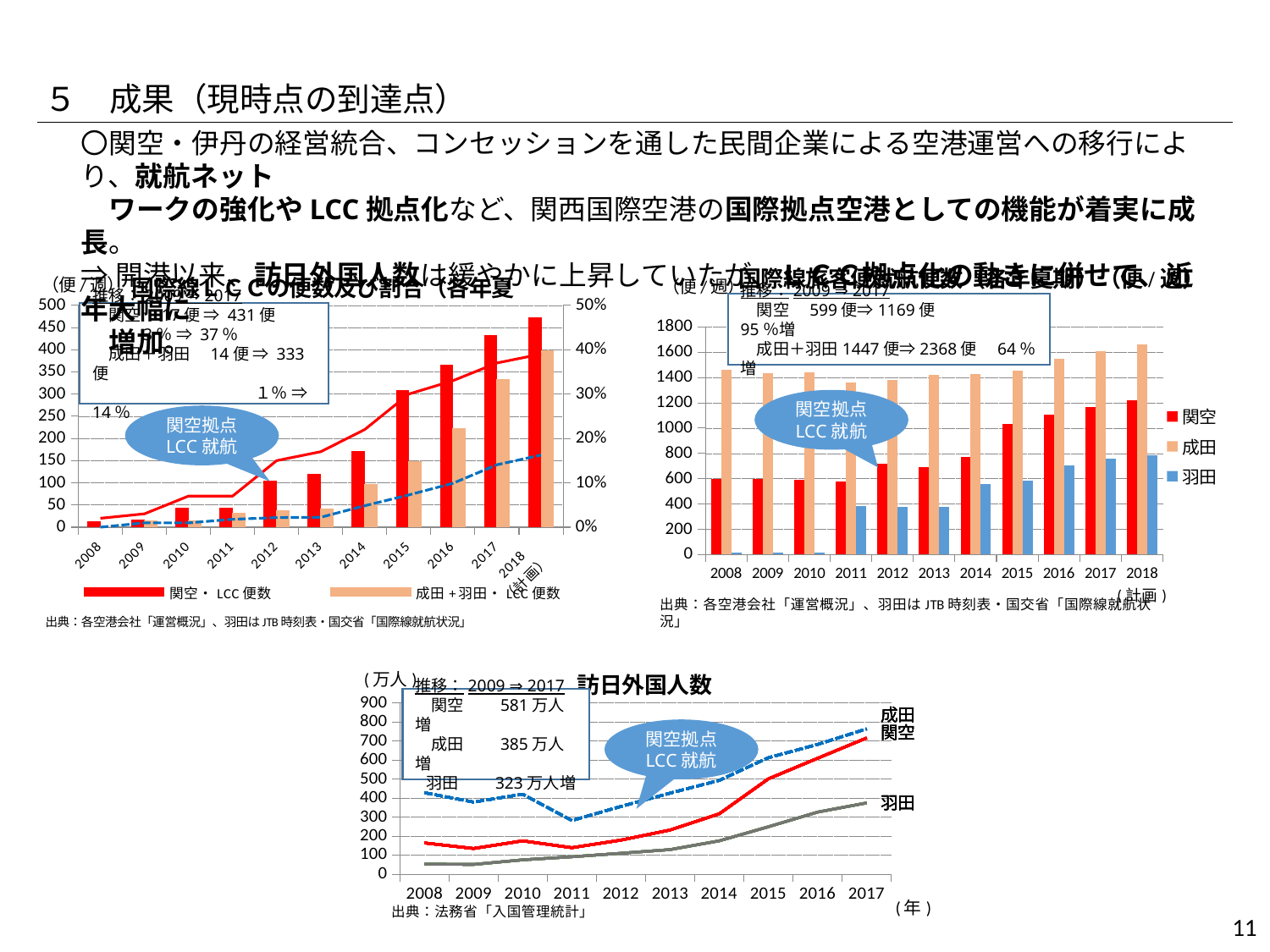
In the top-right chart 国際線旅客便数（各年夏）, how many series does the legend list? 3 What kind of chart is the top-right chart titled 国際線旅客便数（各年夏）? bar chart In the top-right chart 国際線旅客便数（各年夏）, is the value for 羽田 in 2010 greater or less than 200? less In the bottom chart 訪日外国人数, which airport has the lowest value in 2017? 羽田 In the top-left chart 国際線LCCの便数及び割合（各年夏）, is the value for 関空・LCC便数 in 2016 greater or less than 300? greater In the top-right chart 国際線旅客便数（各年夏）, which airport has the highest value in 2018? 成田 In the top-right chart 国際線旅客便数（各年夏）, how many years are shown on the x axis? 11 In the top-left chart 国際線LCCの便数及び割合（各年夏）, do the 関空・LCC便数 bars rise or fall from 2008 to 2018? rise In the top-right chart 国際線旅客便数（各年夏）, which airport has the lowest value in 2010? 羽田 In the top-right chart 国際線旅客便数（各年夏）, is the value for 関空 in 2018 greater or less than 1000? greater What kind of chart is the bottom chart titled 訪日外国人数? line chart